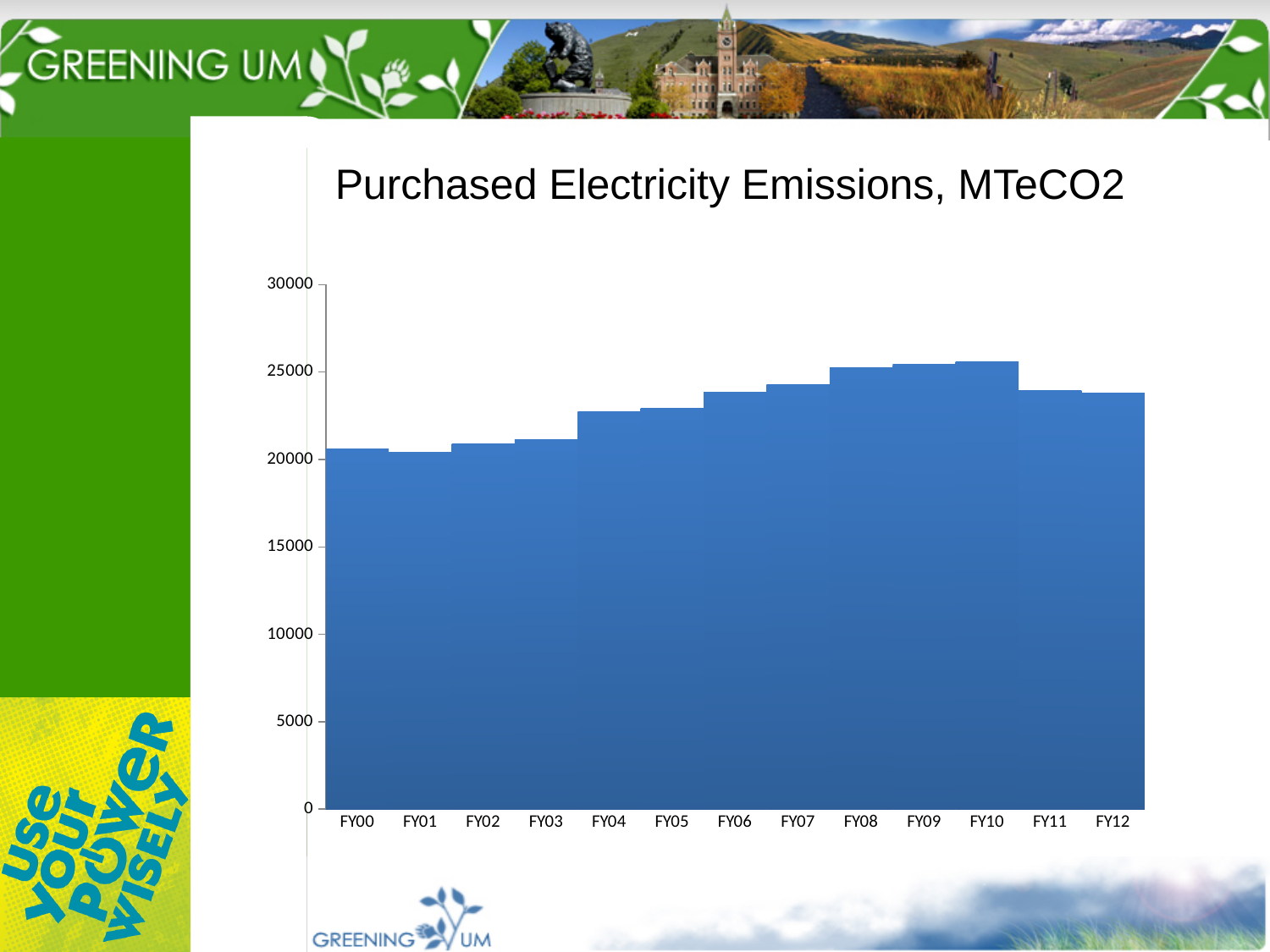
Do the values generally rise or fall from FY00 to FY10? rise Is the value for FY00 greater or less than 20000? greater Do the values rise or fall from FY10 to FY12? fall Is the value for FY10 greater or less than 25000? greater What is the title of the chart? Purchased Electricity Emissions, MTeCO2 Is the value for FY04 greater or less than 25000? less How many fiscal years are shown on the x axis of the chart? 13 What kind of chart is shown on the slide? bar chart Which is larger, the value for FY08 or the value for FY04? FY08 Which is larger, the value for FY02 or the value for FY10? FY10